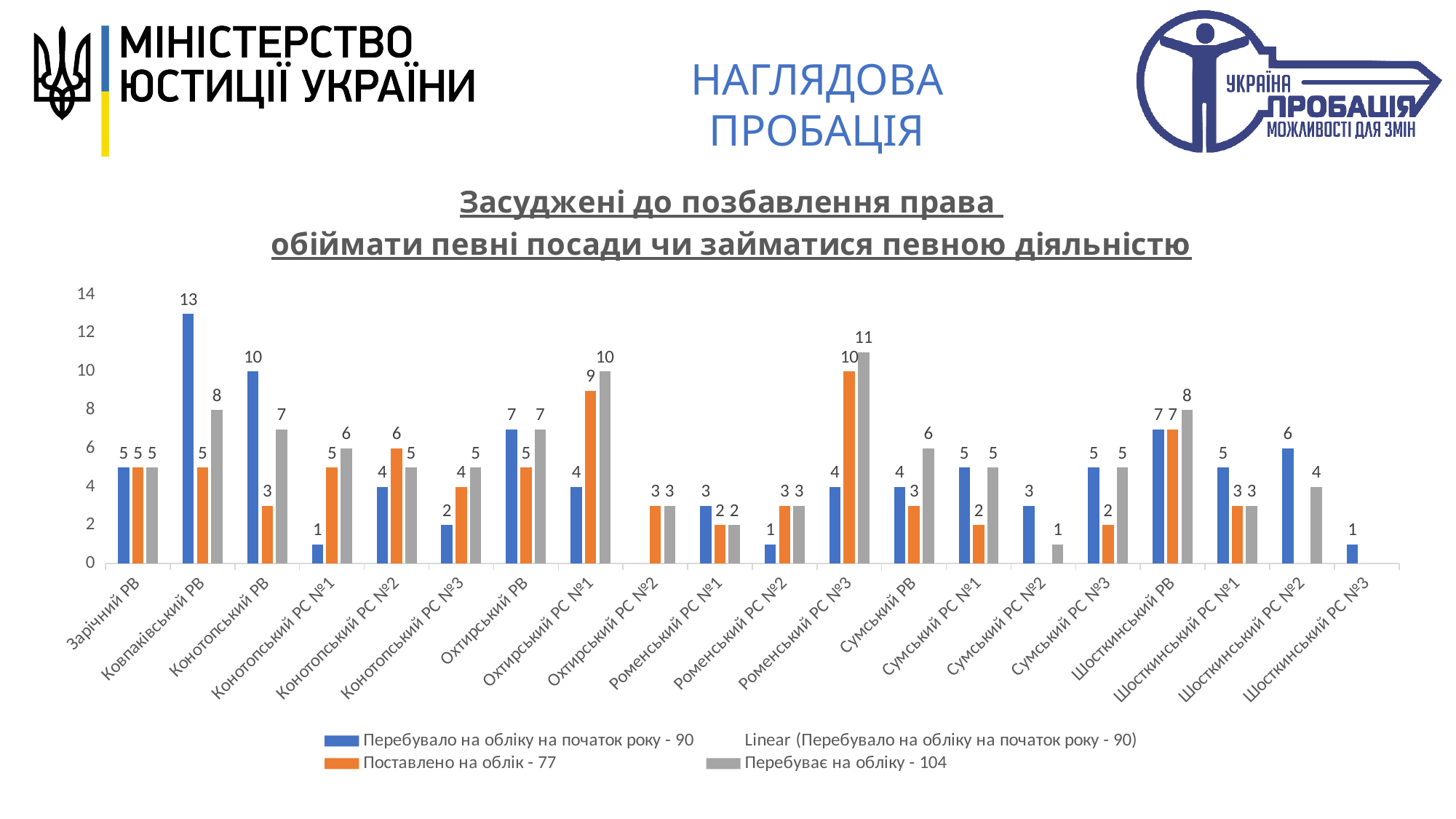
What is the value of "Перебувало на обліку на початок року - 90" for Ковпаківський РВ? 13 How many categories are shown on the x axis? 20 What is the value of "Перебуває на обліку - 104" for Охтирський РС №1? 10 Which category has the highest value for "Перебувало на обліку на початок року - 90"? Ковпаківський РВ What is the value of "Поставлено на облік - 77" for Роменський РС №3? 10 What is the difference between "Перебувало на обліку на початок року - 90" and "Перебуває на обліку - 104" for Ковпаківський РВ? 5 How many entries does the legend list? 4 What kind of chart is shown on the slide? Bar chart What is the value of "Перебуває на обліку - 104" for Сумський РС №2? 1 What colour represents the series "Поставлено на облік - 77"? Orange Which is larger for Конотопський РС №1: "Перебувало на обліку на початок року - 90" or "Поставлено на облік - 77"? Поставлено на облік - 77 Which category has the highest value for "Перебуває на обліку - 104"? Роменський РС №3